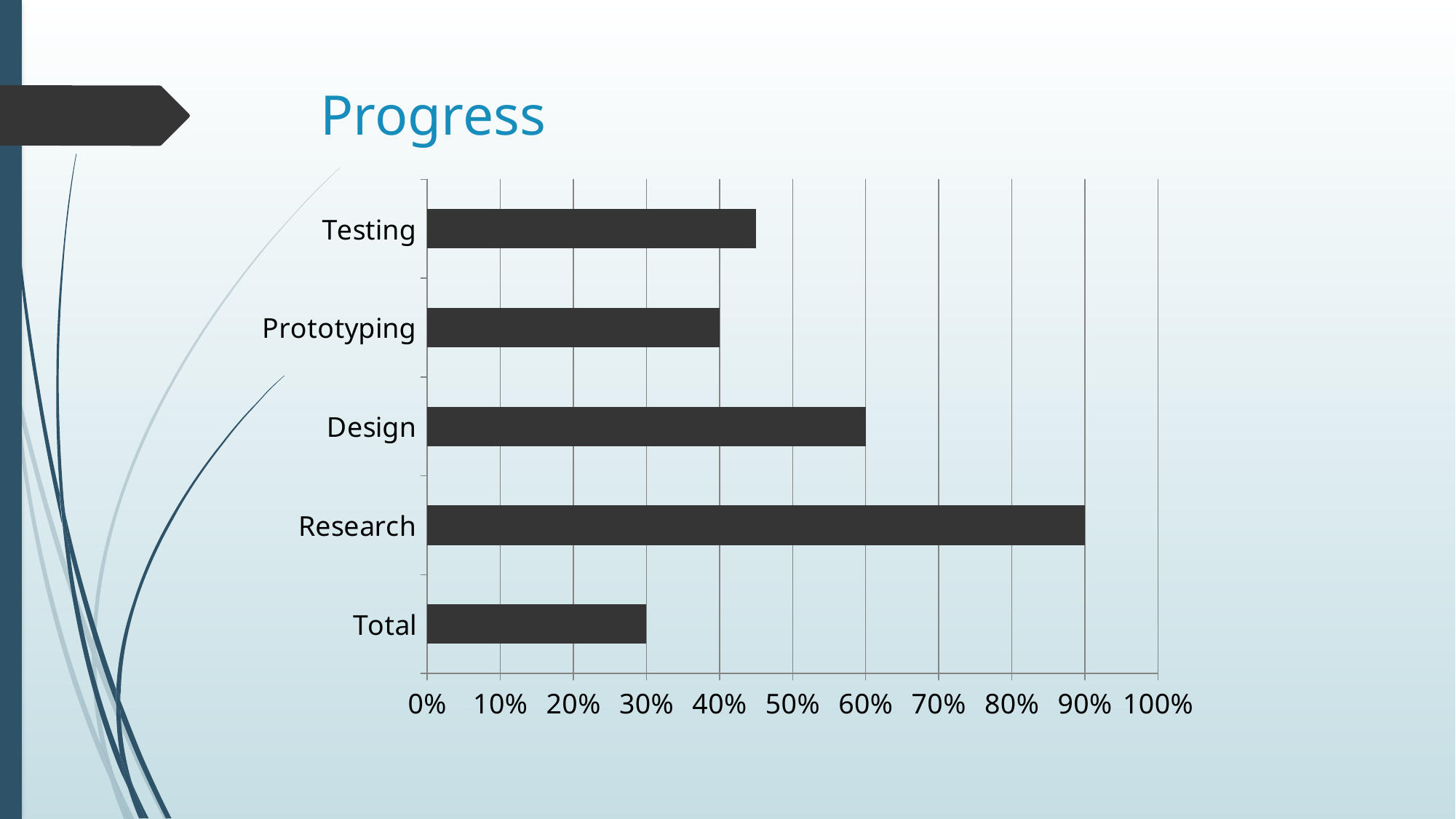
How many categories are plotted in the chart? 5 Which category has the lowest value? Total What is the value for Prototyping? 40% What kind of chart is shown on the slide? bar chart What is the title of the slide containing the chart? Progress What is the value for Research? 90% What is the difference between the values for Research and Design? 30% What is the value for Total? 30% Is the value for Testing greater or less than 50%? less Which category has the highest value? Research Which is larger, the value for Testing or the value for Prototyping? Testing What is the value for Design? 60%